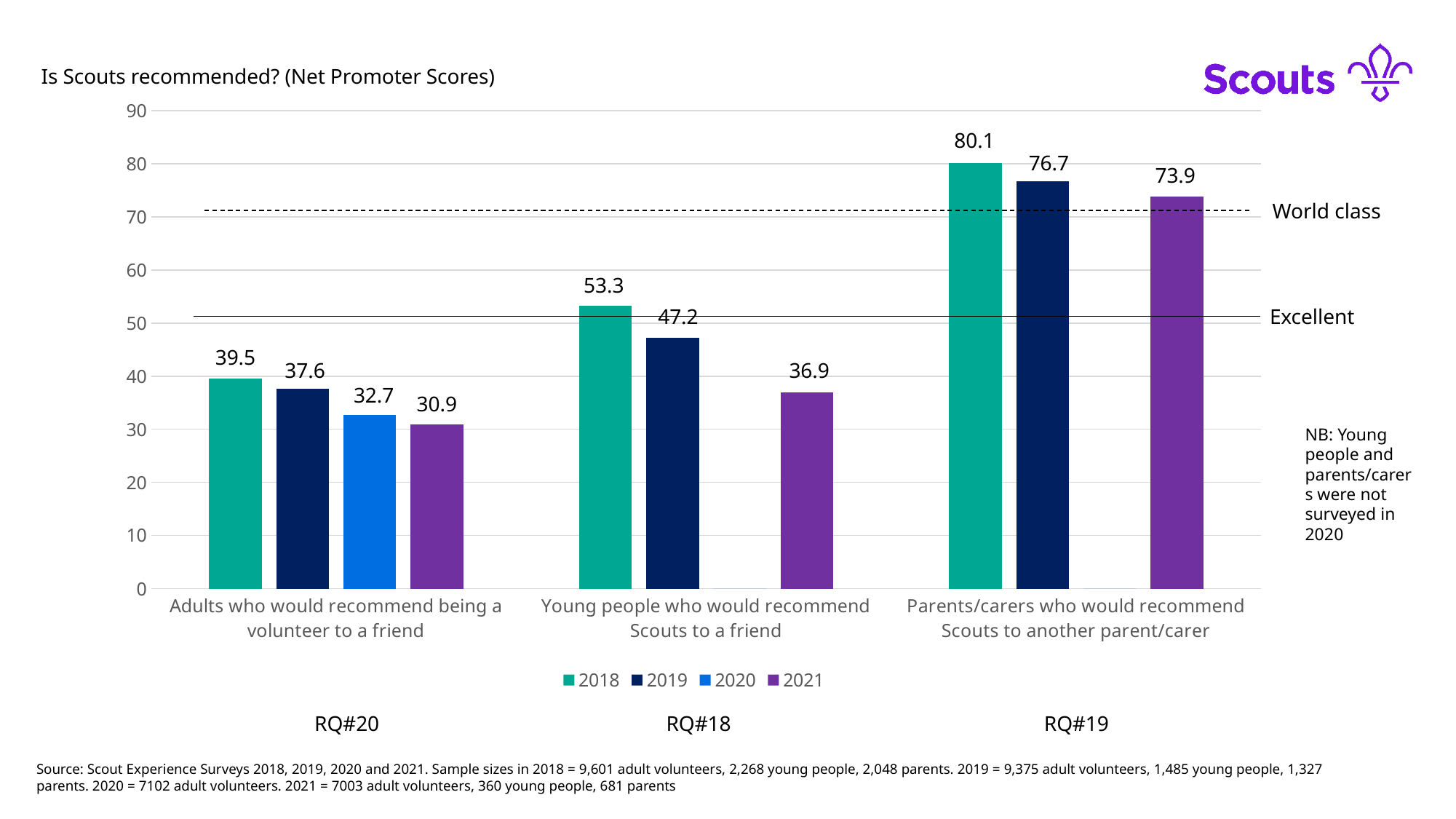
What kind of chart is shown on the slide? Bar chart Do the scores for adults who would recommend being a volunteer to a friend rise or fall from 2018 to 2021? Fall How many categories are shown on the x axis? 3 Which is larger: the 2019 score for young people who would recommend Scouts to a friend, or the 2018 score for adults who would recommend being a volunteer to a friend? 2019 score for young people who would recommend Scouts to a friend What is the 2021 Net Promoter Score for young people who would recommend Scouts to a friend? 36.9 What is the title of the chart? Is Scouts recommended? (Net Promoter Scores) What is the 2018 Net Promoter Score for adults who would recommend being a volunteer to a friend? 39.5 What is the difference between the 2018 and 2021 scores for parents/carers who would recommend Scouts to another parent/carer? 6.2 Which year has the lowest score for adults who would recommend being a volunteer to a friend? 2021 What is the 2019 Net Promoter Score for parents/carers who would recommend Scouts to another parent/carer? 76.7 How many series does the legend list? 4 Which category has the highest 2018 Net Promoter Score? Parents/carers who would recommend Scouts to another parent/carer